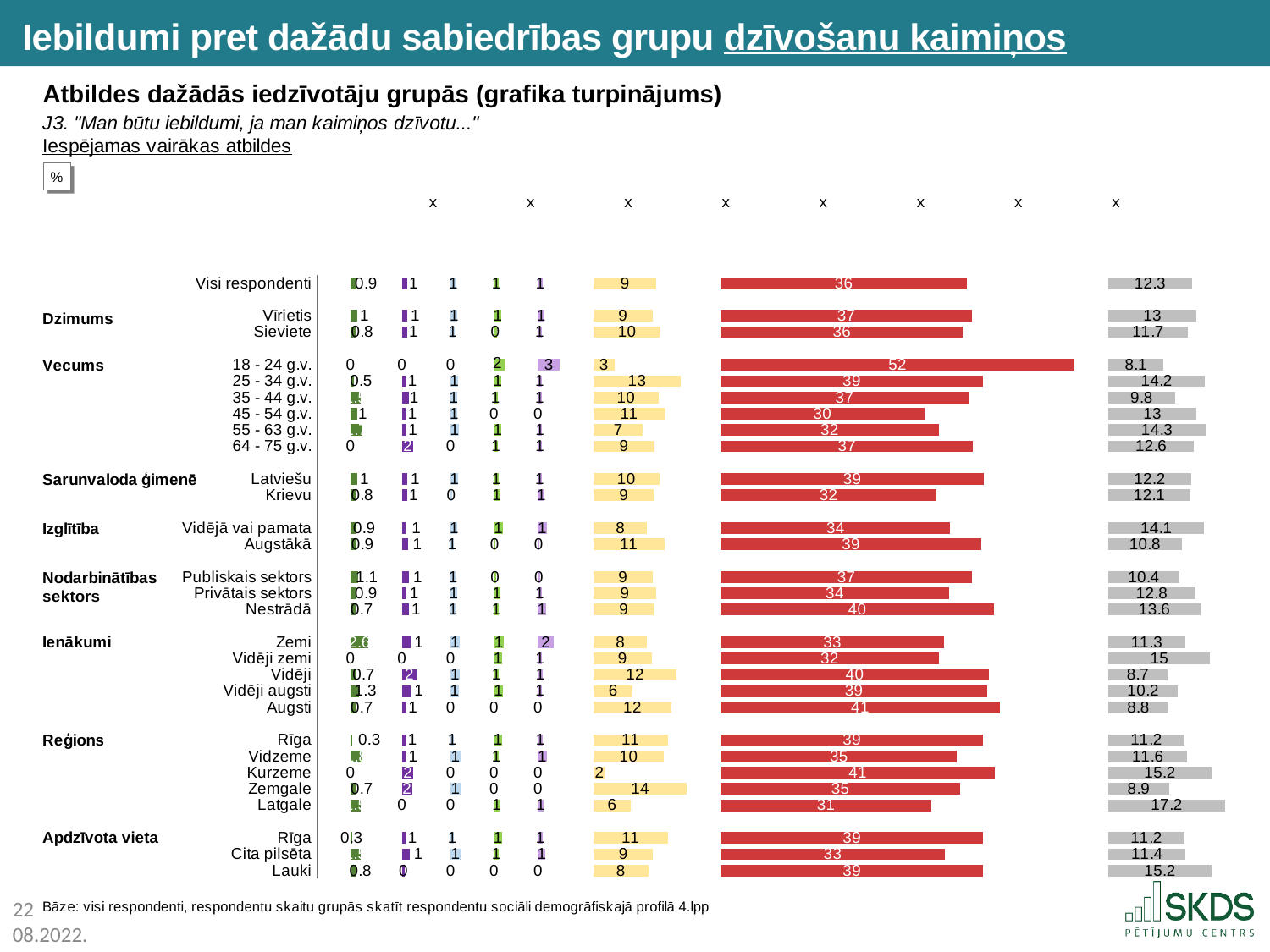
In the grey bar column on the right, what is the value for Latgale? 17.2 In the red bar column, which age group (Vecums) has the lowest value? 45 - 54 g.v. In the yellow bar column, which is larger: the value for Vidēji augsti or the value for Augsti? Augsti In the red bar column, which is larger: the value for Latviešu or the value for Krievu? Latviešu What kind of chart is shown on the slide? Bar chart In the red bar column, what is the difference between the values for 18 - 24 g.v. and 45 - 54 g.v.? 22 In the yellow bar column, what is the value for Zemgale? 14 In the red bar column, which age group (Vecums) has the highest value? 18 - 24 g.v. In the grey bar column on the right, which region (Reģions) has the highest value? Latgale In the grey bar column on the right, what is the difference between the values for Vīrietis and Sieviete? 1.3 How many age groups are listed under Vecums? 6 In the red bar column, what is the value for Visi respondenti? 36